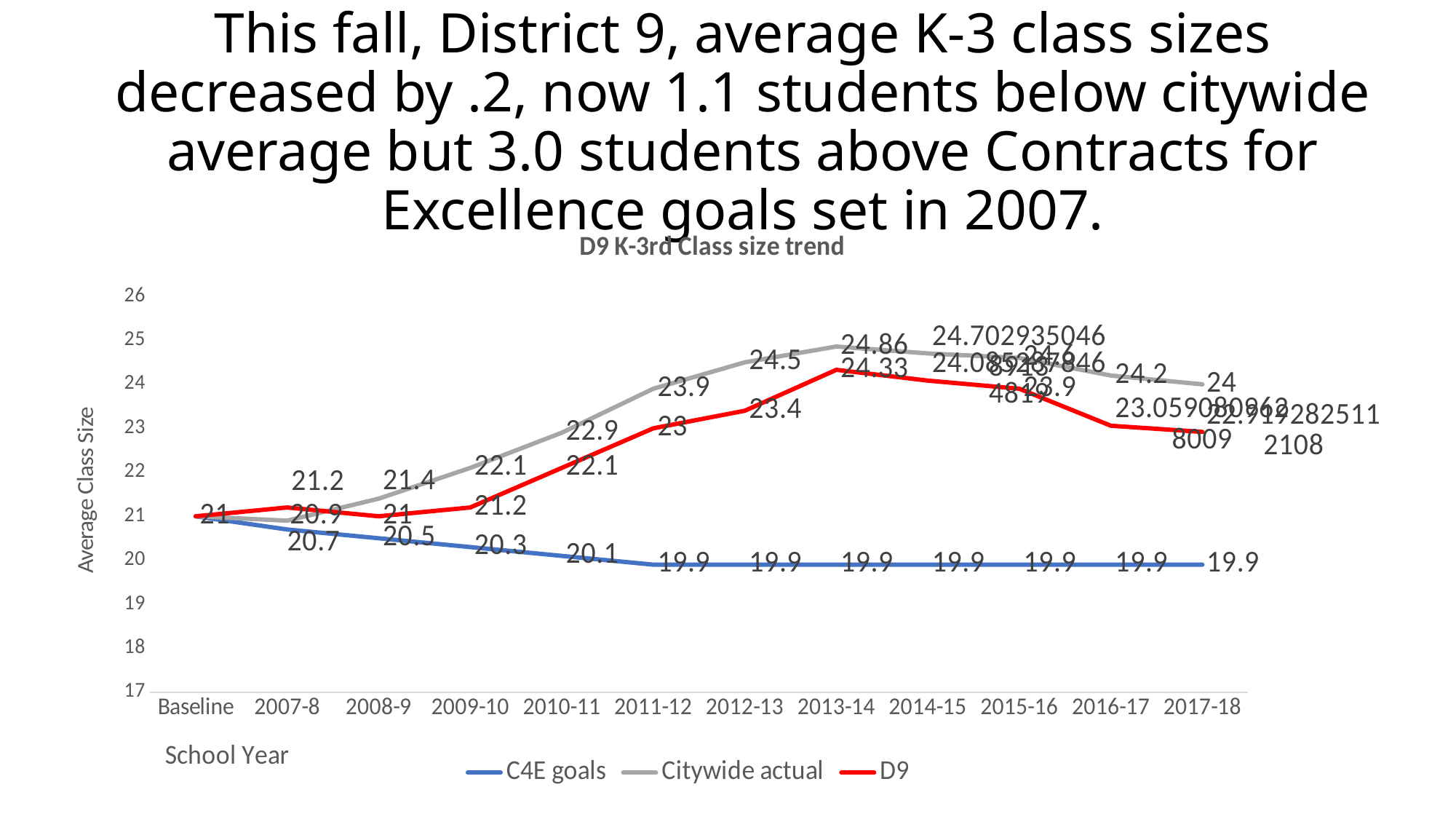
What is the D9 value for 2013-14? 24.33 How many school-year categories are shown on the x axis? 12 How many series does the legend list? 3 What is the C4E goals value for 2017-18? 19.9 Do the C4E goals values rise or fall from Baseline to 2011-12? fall What is the difference between the Citywide actual and D9 values in 2012-13? 1.1 What kind of chart is shown on the slide? line chart What is the Citywide actual value for 2012-13? 24.5 In 2011-12, which is larger: Citywide actual or D9? Citywide actual What is the title of the chart? D9 K-3rd Class size trend In which school year does the Citywide actual series reach its highest value? 2013-14 What is the D9 value for 2010-11? 22.1